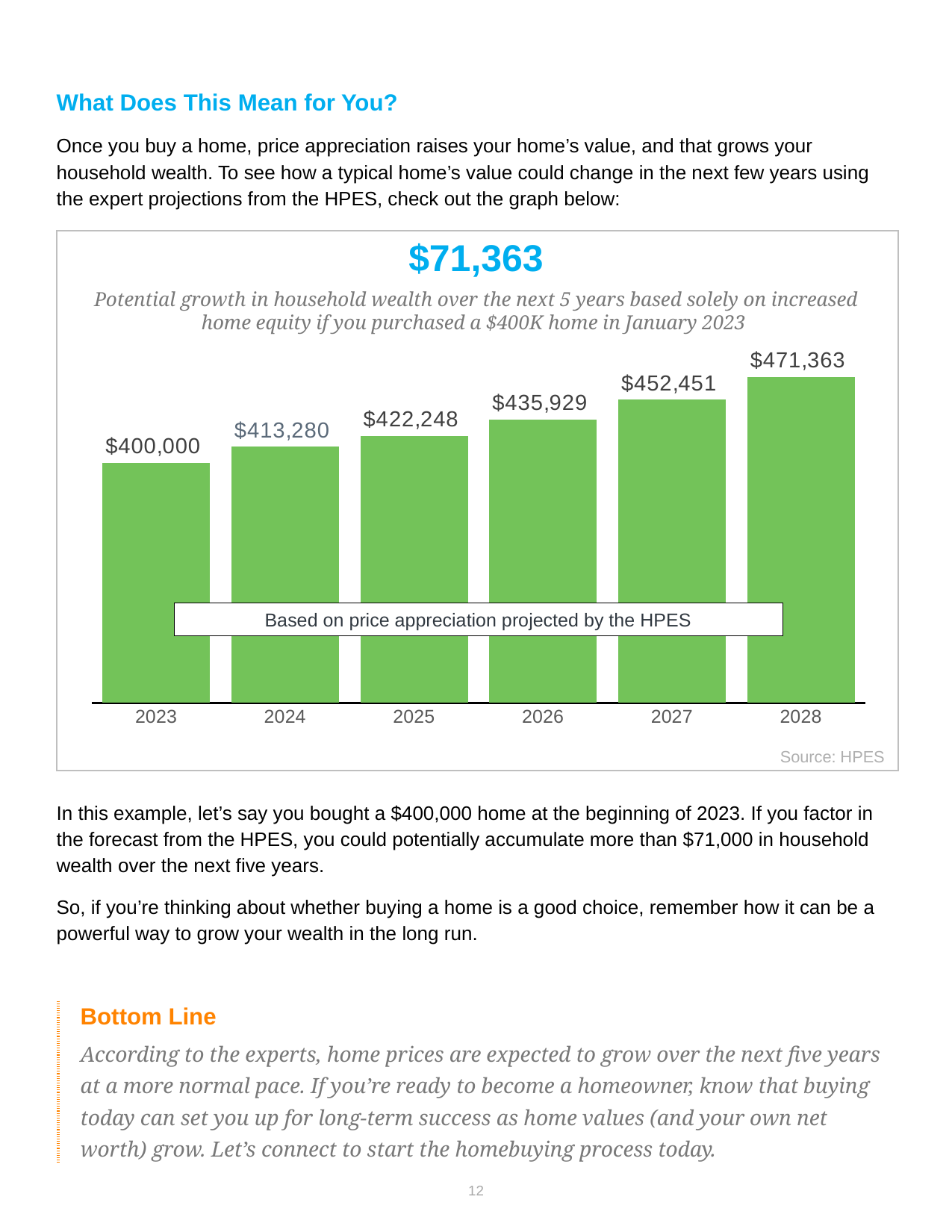
Which is larger, the value for 2024 or the value for 2026? 2026 Do the home values rise or fall from 2023 to 2028? Rise Which year has the lowest home value on the chart? 2023 What is the difference between the values for 2026 and 2025? $13,681 What kind of chart is shown on the slide? Bar chart Which year has the highest projected home value? 2028 What is the projected home value for 2027? $452,451 What is the source cited for the chart? HPES What is the difference between the home value in 2028 and the home value in 2023? $71,363 What is the projected home value for 2025? $422,248 What is the home value shown for 2023? $400,000 How many years are shown on the x axis of the chart? 6